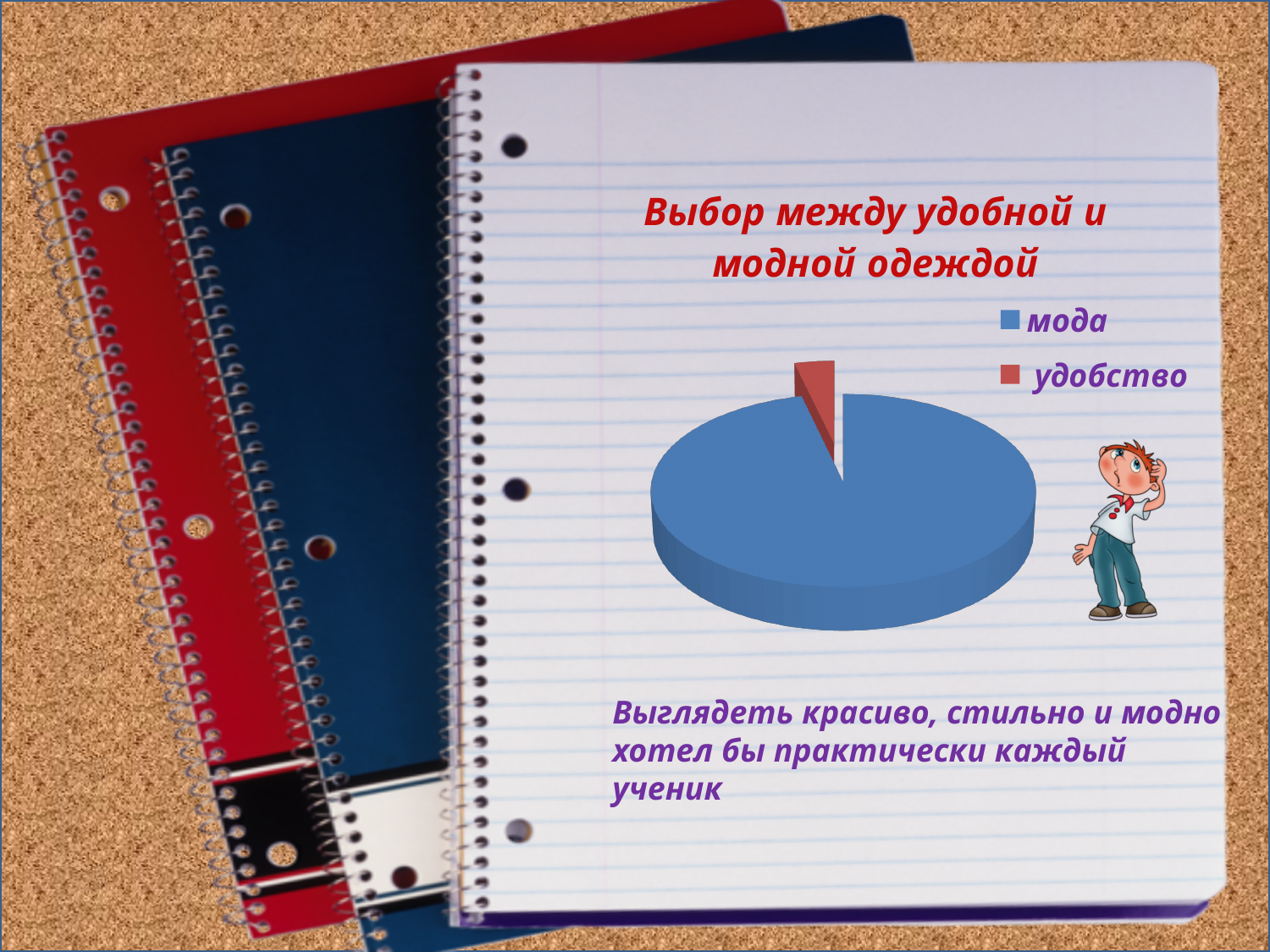
What kind of chart is shown on the slide? pie chart How many slices does the pie chart have? 2 Which slice is larger, мода or удобство? мода How many entries does the chart legend list? 2 What is the title of the chart? Выбор между удобной и модной одеждой Which category has the largest slice of the pie? мода What colour is the slice for удобство? red Which category has the smallest slice of the pie? удобство